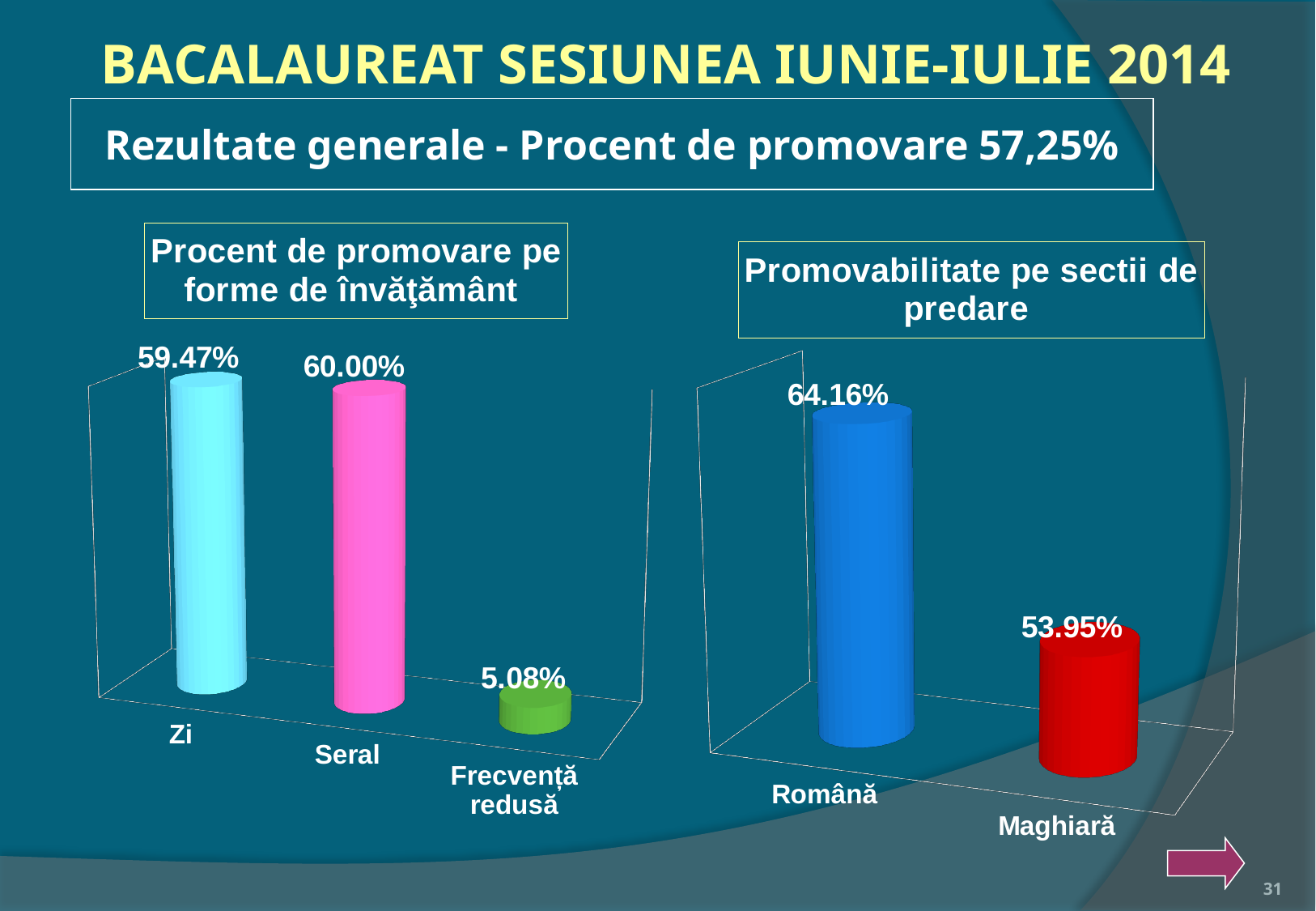
In the chart 'Procent de promovare pe forme de învăţământ', what is the value for Frecvență redusă? 5.08% What kind of chart is 'Promovabilitate pe sectii de predare'? Bar chart What colour is the bar for Maghiară in the chart 'Promovabilitate pe sectii de predare'? Red In the chart 'Promovabilitate pe sectii de predare', what is the value for Maghiară? 53.95% In the chart 'Promovabilitate pe sectii de predare', what is the difference between the values for Română and Maghiară? 10.21 percentage points In the chart 'Promovabilitate pe sectii de predare', which category has the higher value, Română or Maghiară? Română In the chart 'Procent de promovare pe forme de învăţământ', what is the value for Zi? 59.47% In the chart 'Procent de promovare pe forme de învăţământ', which category has the lowest value? Frecvență redusă In the chart 'Promovabilitate pe sectii de predare', what is the value for Română? 64.16% How many categories are shown in the chart 'Procent de promovare pe forme de învăţământ'? 3 In the chart 'Procent de promovare pe forme de învăţământ', which category has the highest value? Seral In the chart 'Procent de promovare pe forme de învăţământ', what is the difference between the values for Seral and Zi? 0.53 percentage points